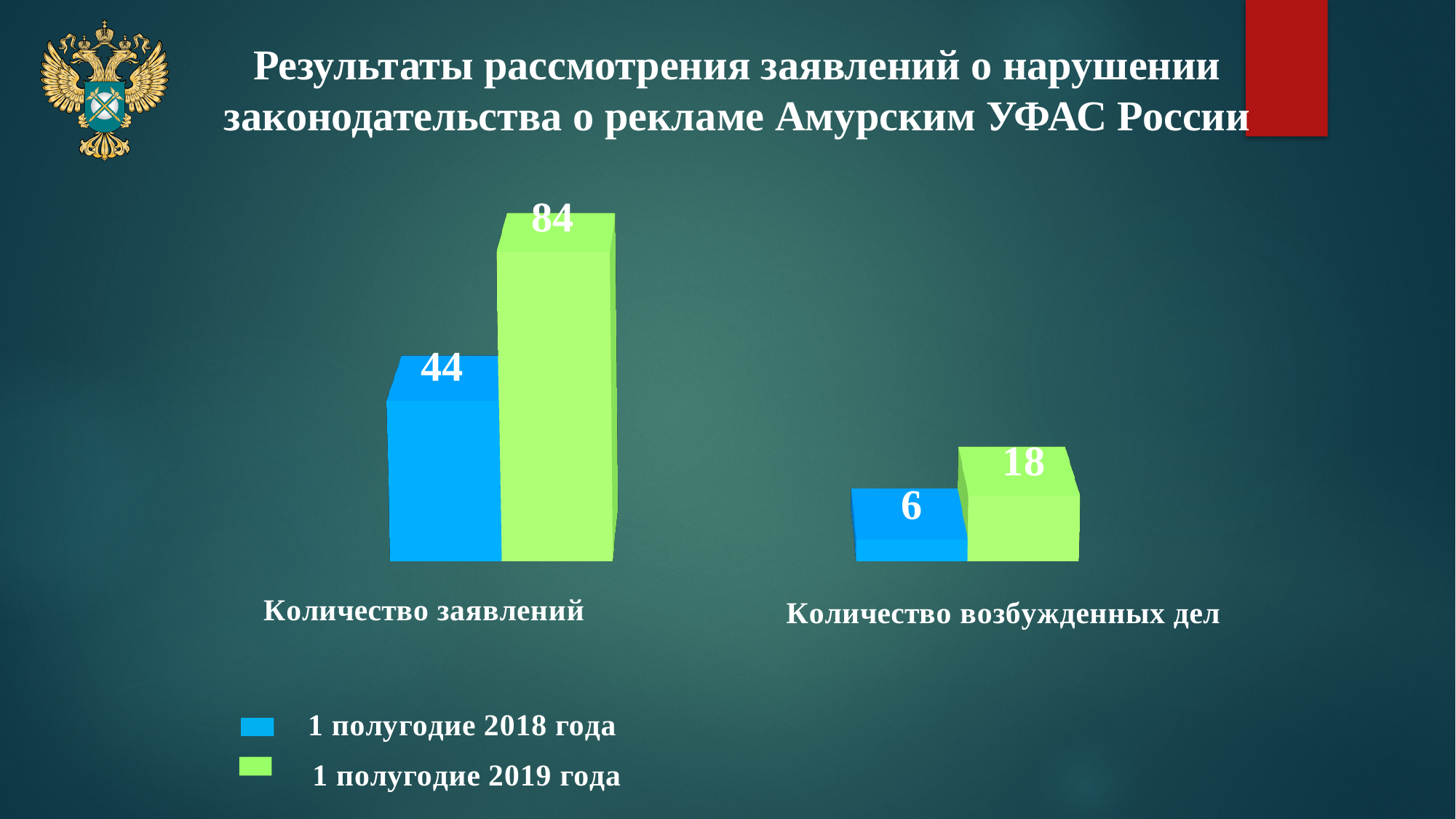
What is the value for «Количество заявлений» in «1 полугодие 2018 года»? 44 How many series does the legend list? 2 What is the value for «Количество возбужденных дел» in «1 полугодие 2018 года»? 6 What is the value for «Количество возбужденных дел» in «1 полугодие 2019 года»? 18 What kind of chart is shown on the slide? Bar chart Which category has the highest value in «1 полугодие 2019 года»? Количество заявлений What is the value for «Количество заявлений» in «1 полугодие 2019 года»? 84 How many categories are shown on the x axis of the chart? 2 Which category has the lowest value in «1 полугодие 2018 года»? Количество возбужденных дел What is the difference between the «1 полугодие 2019 года» and «1 полугодие 2018 года» values for «Количество заявлений»? 40 What is the difference between the «1 полугодие 2019 года» and «1 полугодие 2018 года» values for «Количество возбужденных дел»? 12 For «Количество возбужденных дел», which series has the larger value: «1 полугодие 2018 года» or «1 полугодие 2019 года»? 1 полугодие 2019 года